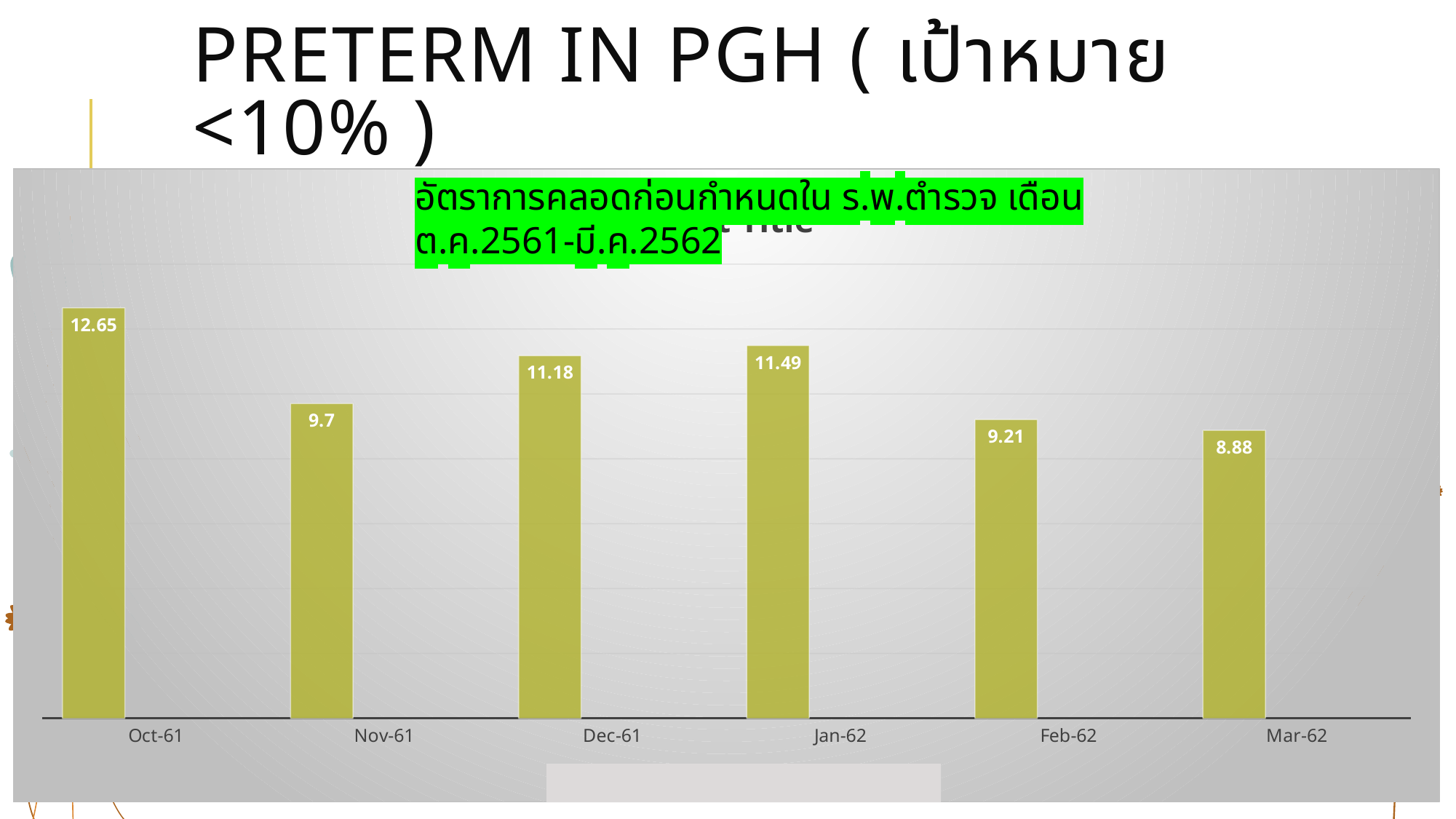
What is the difference between the values for Feb-62 and Mar-62? 0.33 What is the value for Mar-62? 8.88 What is the value for Nov-61? 9.7 What kind of chart is shown on the slide? Bar chart How many months are shown on the x axis? 6 Which month has the highest value? Oct-61 Which is larger, the value for Dec-61 or the value for Jan-62? Jan-62 What is the difference between the values for Oct-61 and Mar-62? 3.77 What is the value for Oct-61? 12.65 What is the value for Jan-62? 11.49 Which month has the lowest value? Mar-62 What is the value for Dec-61? 11.18